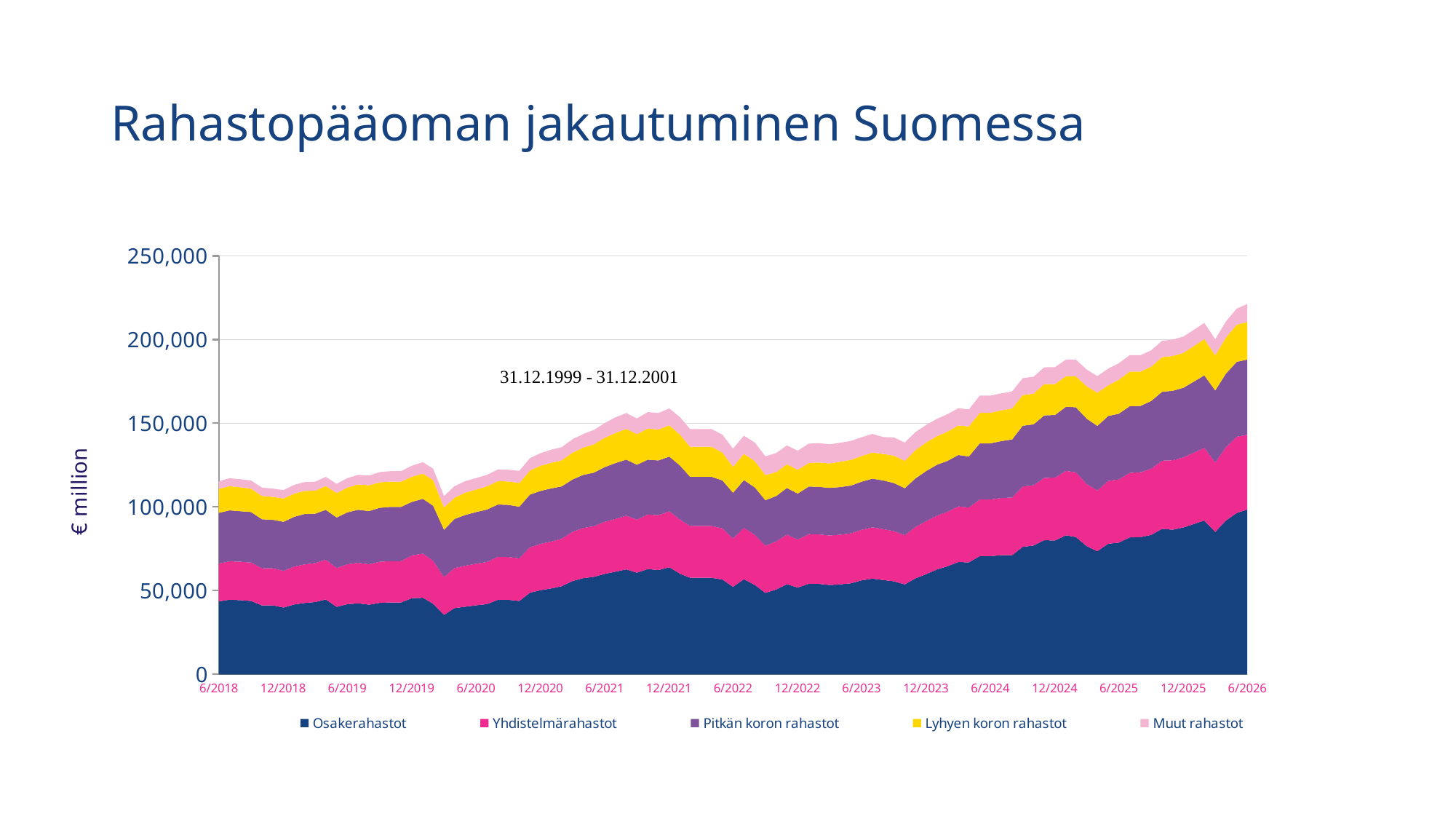
How many date labels are shown on the horizontal axis? 17 What kind of chart is shown on the slide? Stacked area chart Is the total value of all series at 6/2018 greater or less than 100,000? greater What is the title of the chart? Rahastopääoman jakautuminen Suomessa Is the total value of all series at 6/2022 greater or less than 150,000? less What is the label on the vertical axis? € million Which is larger: the value for Osakerahastot at 6/2026 or at 6/2018? 6/2026 Which series is at the bottom of the stack? Osakerahastot Is the value for Osakerahastot at 6/2018 greater or less than 50,000? less Does the total fund capital rise or fall overall from 6/2018 to 6/2026? rise How many series does the legend list? 5